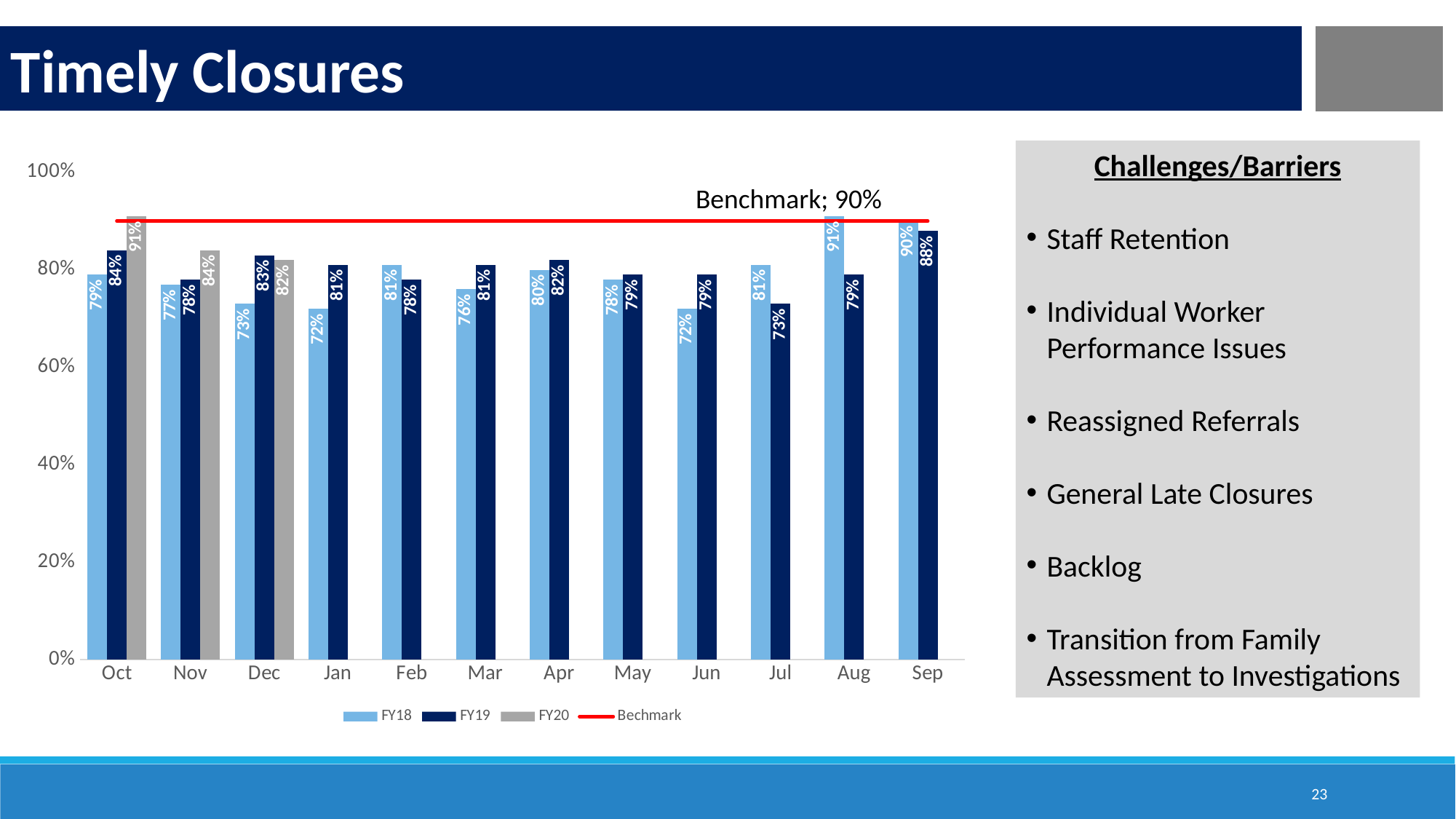
What is the FY20 value for Nov? 84% How many entries does the legend list? 4 What is the difference between the FY19 and FY18 values for Dec? 10% Is the FY20 value for Oct greater or less than 80%? greater Which is larger for Feb, the FY18 value or the FY19 value? FY18 What value does the red benchmark line represent? 90% What is the FY18 value for Jul? 81% Which month has the highest FY18 value? Aug Which month has the lowest FY19 value? Jul How many months are shown on the x axis? 12 What kind of chart is shown on the slide? Combination bar and line chart What is the FY19 value for Oct? 84%